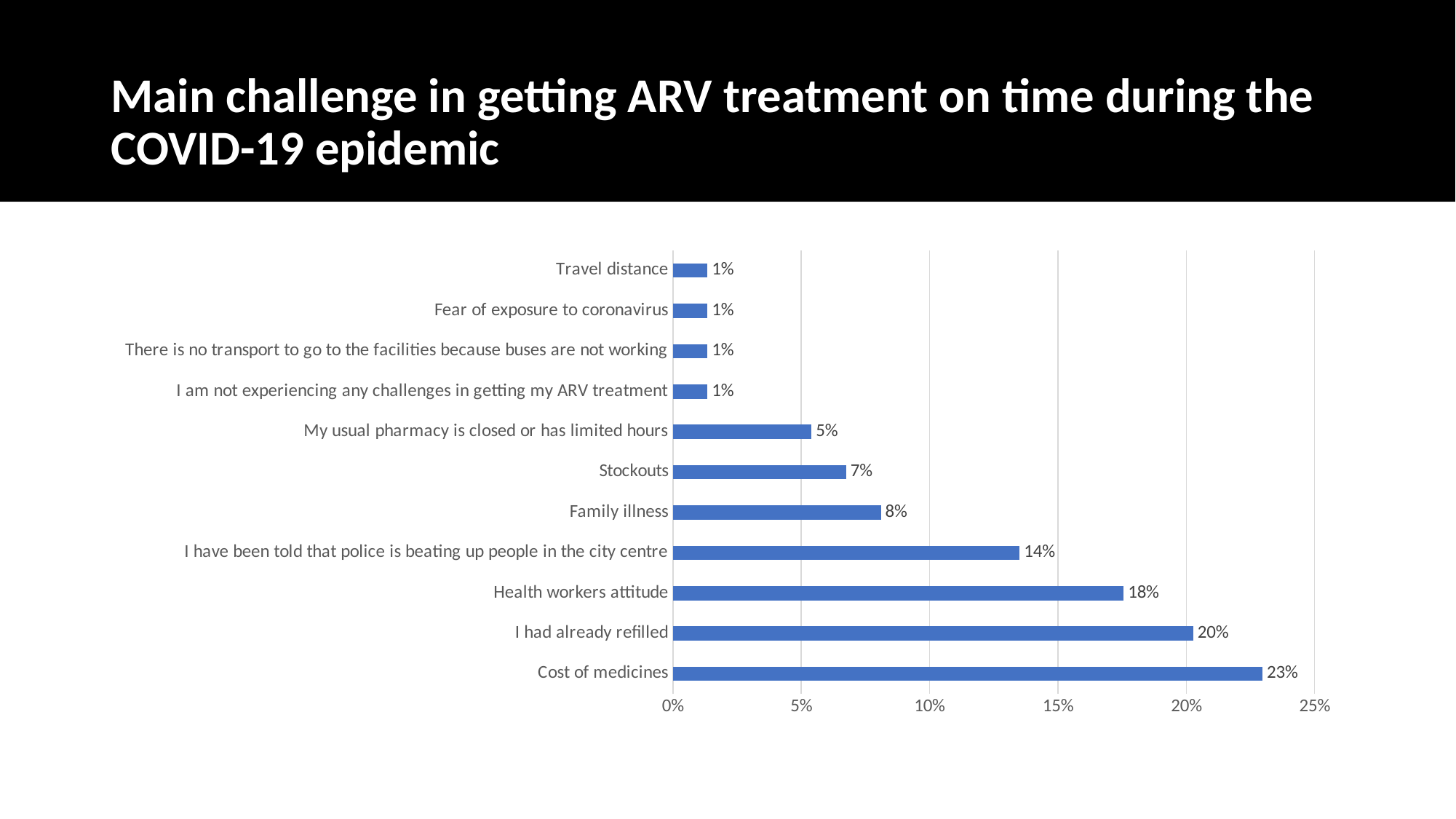
What is the title of the slide? Main challenge in getting ARV treatment on time during the COVID-19 epidemic What is the value for My usual pharmacy is closed or has limited hours? 5% What is the difference between the values for Health workers attitude and Family illness? 10% How many categories are shown in the chart? 11 What percentage is shown for Stockouts? 7% Which challenge has the highest percentage? Cost of medicines Which is larger, the value for Stockouts or the value for Family illness? Family illness Is the value for I have been told that police is beating up people in the city centre greater or less than 10%? greater What kind of chart is shown on the slide? Bar chart What is the value for Health workers attitude? 18% What is the difference between the values for Cost of medicines and I had already refilled? 3% What percentage is shown for Cost of medicines? 23%